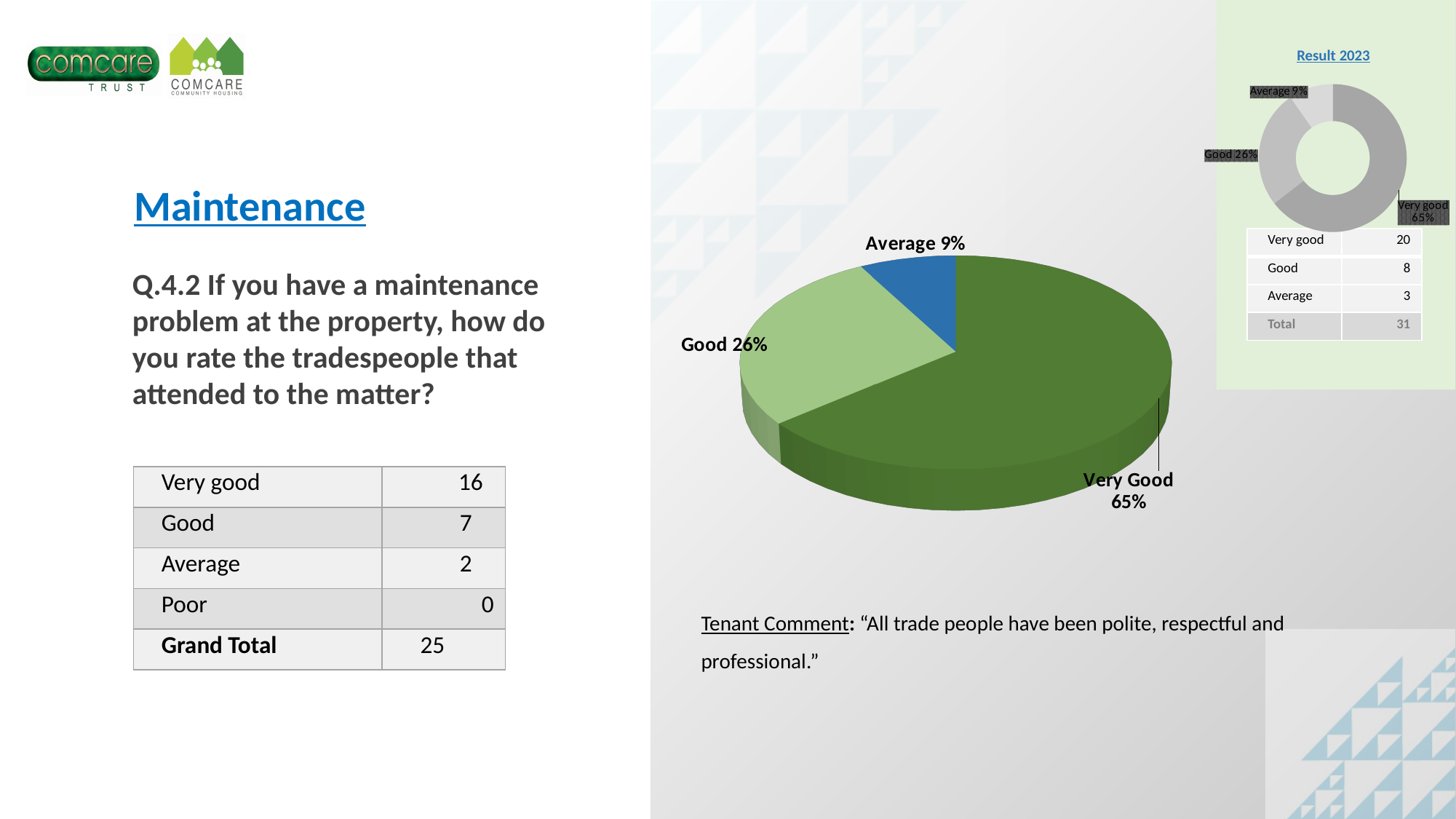
On the large pie chart, which category has the smallest slice? Average On the small Result 2023 chart, what percentage is shown for Very good? 65% On the large pie chart, what colour is the Average slice? Blue How many slices does the large pie chart have? 3 On the large pie chart, what percentage is shown for Good? 26% On the large pie chart, what is the difference in percentage points between Very Good and Good? 39 On the large pie chart, which category has the largest slice? Very Good On the large pie chart, which is larger, the Good slice or the Average slice? Good On the large pie chart, what percentage is shown for Average? 9% What kind of chart is the large chart in the centre of the slide? Pie chart On the large pie chart, what percentage is shown for Very Good? 65% What is the title of the small chart in the top right of the slide? Result 2023